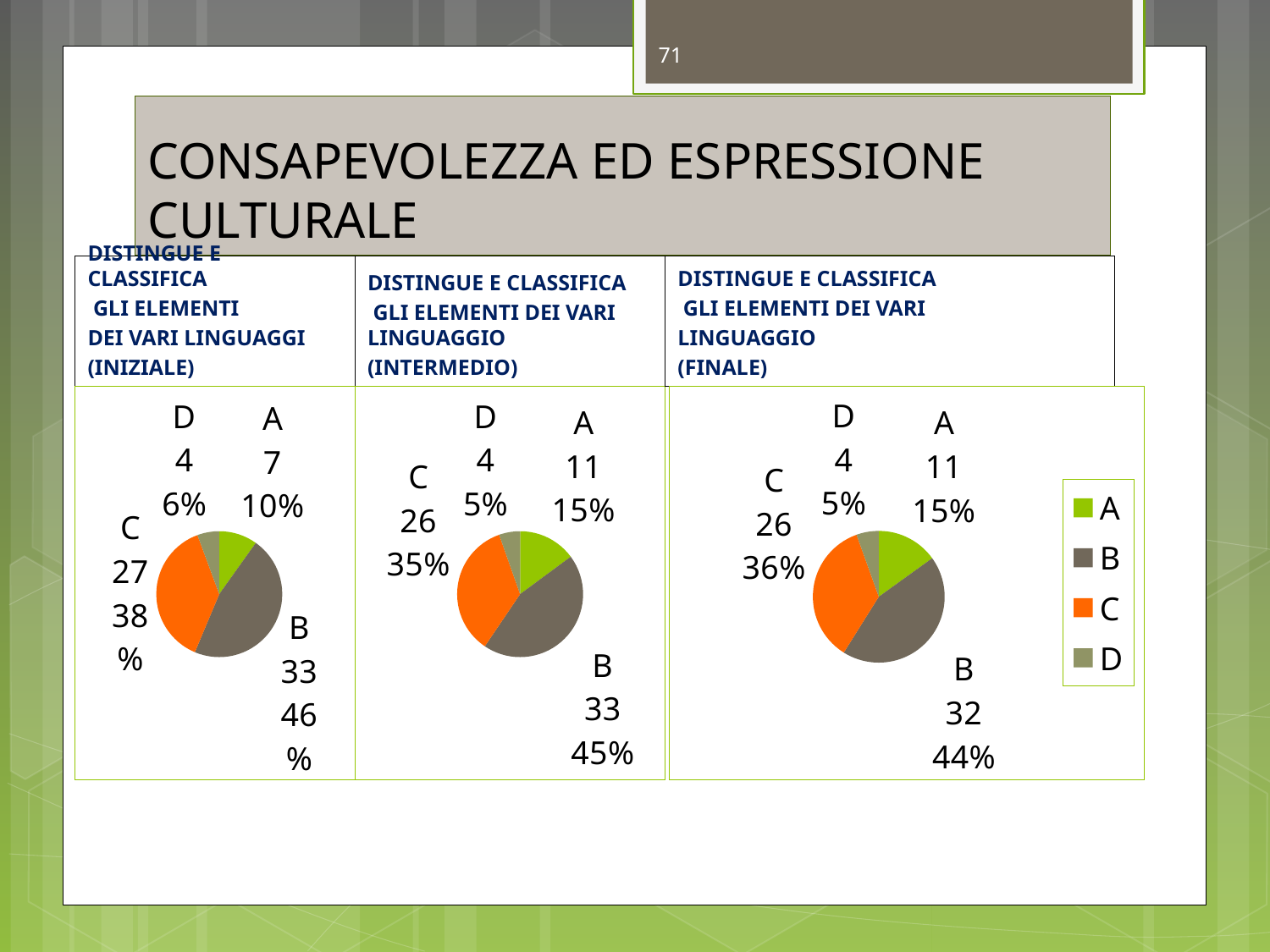
In the right (FINALE) pie chart, which category has the largest share? B How many categories does each pie chart show? 4 In the right (FINALE) pie chart, what is the difference between the values for B and C? 6 In the middle (INTERMEDIO) pie chart, which is larger, the value for A or the value for C? C In the left (INIZIALE) pie chart, what is the value for category B? 33 In the middle (INTERMEDIO) pie chart, what is the value for category A? 11 What type of chart is used on this slide? pie chart In the middle (INTERMEDIO) pie chart, what percentage share does category D have? 5% In the left (INIZIALE) pie chart, what percentage share does category C have? 38% Which colour represents category C in the legend? orange In the left (INIZIALE) pie chart, which category has the smallest share? D In the right (FINALE) pie chart, what is the value for category C? 26